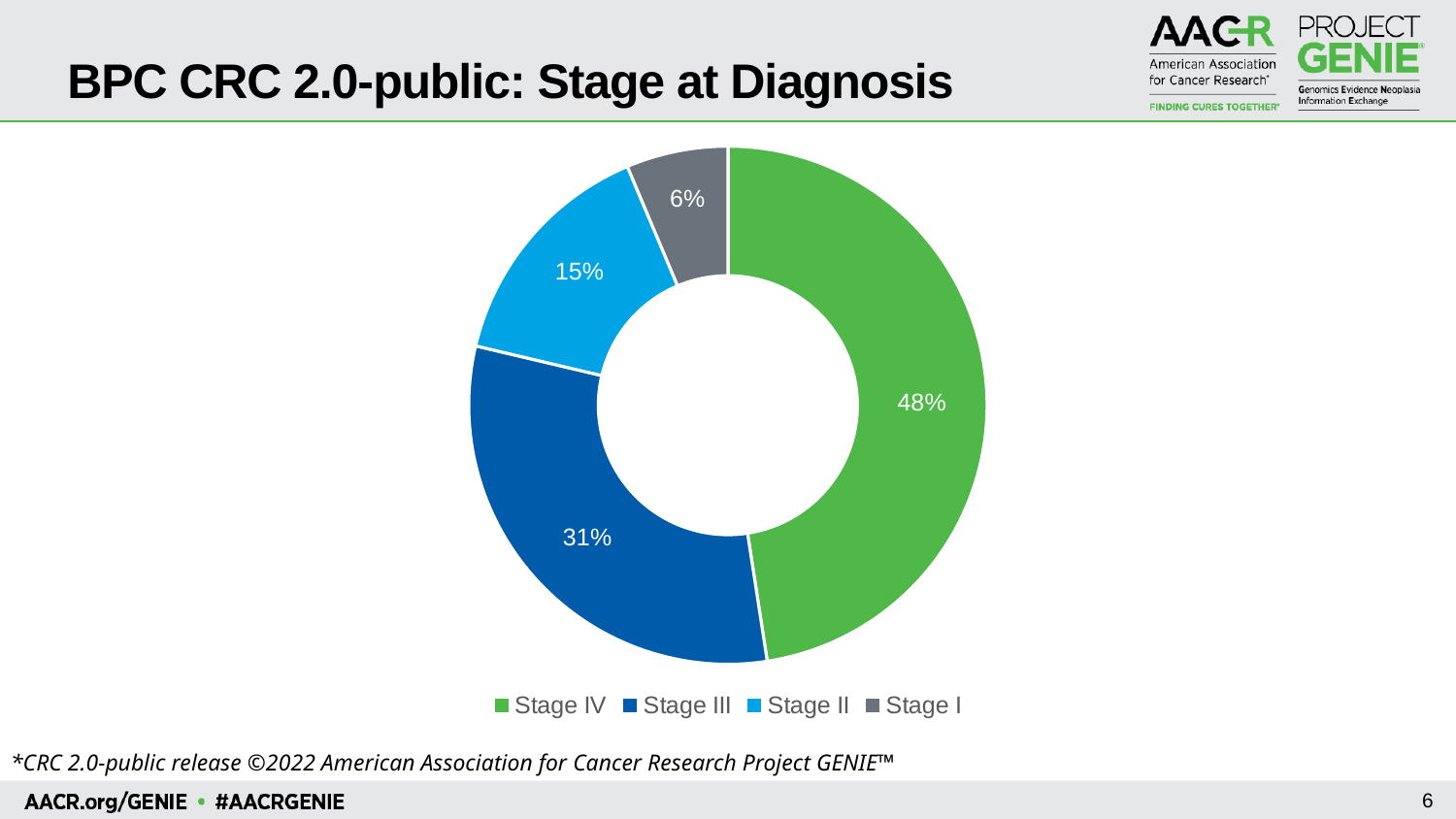
What percentage of cases are Stage IV at diagnosis? 48% Which is larger, the share for Stage II or the share for Stage I? Stage II What colour represents Stage III in the chart? Dark blue What percentage of cases are Stage I at diagnosis? 6% Which stage has the smallest share of the chart? Stage I What percentage of cases are Stage II at diagnosis? 15% What percentage of cases are Stage III at diagnosis? 31% What is the difference in percentage points between Stage IV and Stage III? 17 Which stage has the largest share of the chart? Stage IV How many stage categories does the chart show? 4 What kind of chart is shown on the slide? Doughnut (pie) chart What is the title of the slide containing the chart? BPC CRC 2.0-public: Stage at Diagnosis